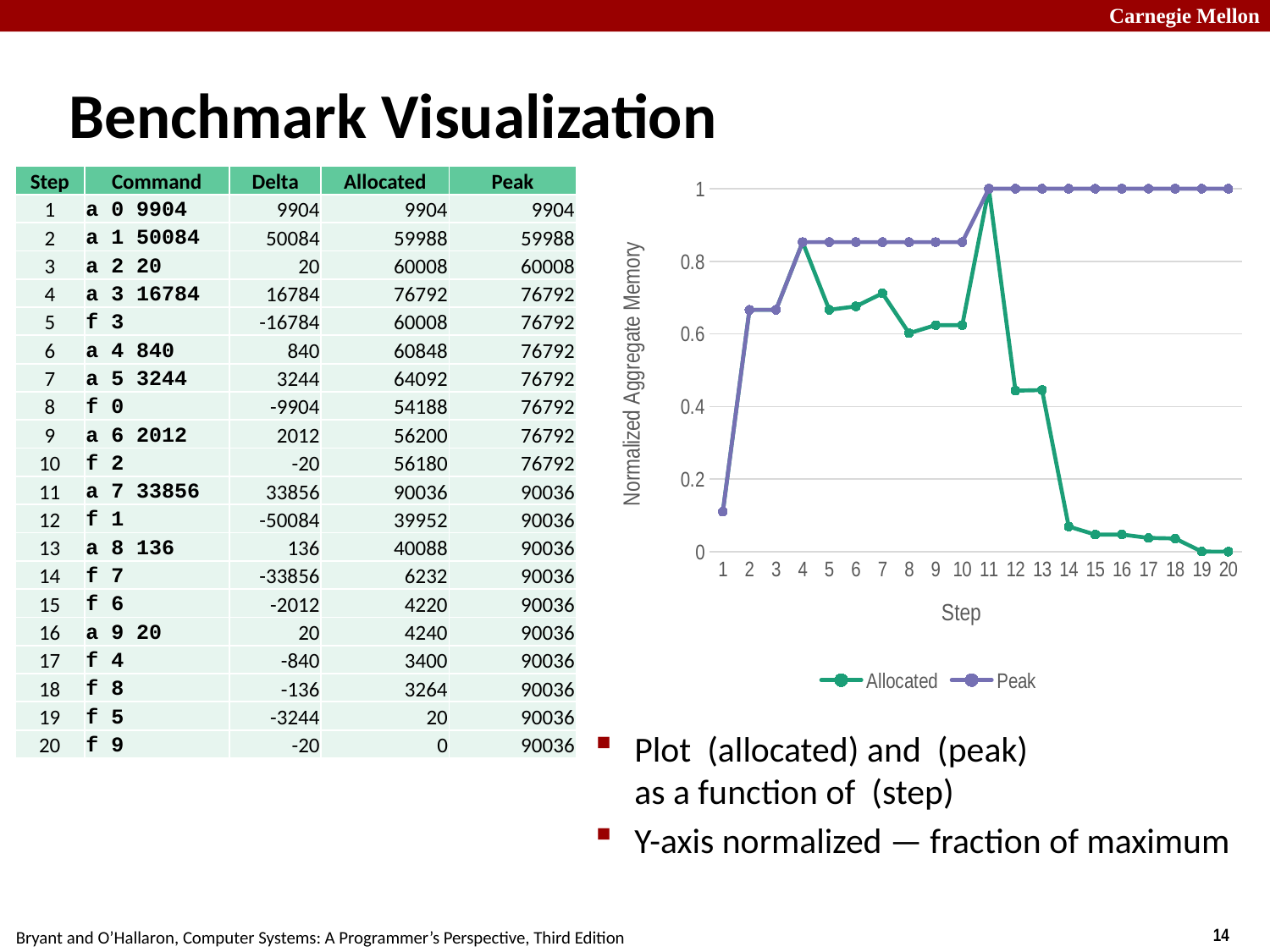
Is the value of the Allocated series at step 1 greater or less than 0.2? less How many steps are plotted along the x axis of the chart? 20 What is the label of the chart's y axis? Normalized Aggregate Memory What is the value of the Allocated series at step 20? 0 At step 5, which series has the larger value, Allocated or Peak? Peak At which step is the Peak series at its lowest value? 1 How many series does the chart legend list? 2 Is the value of the Peak series at step 4 greater or less than 0.8? greater What is the value of the Peak series at step 15? 1 What are the two series named in the chart legend? Allocated and Peak At which step does the Allocated series reach its highest value? 11 What kind of chart is shown on the slide? line chart